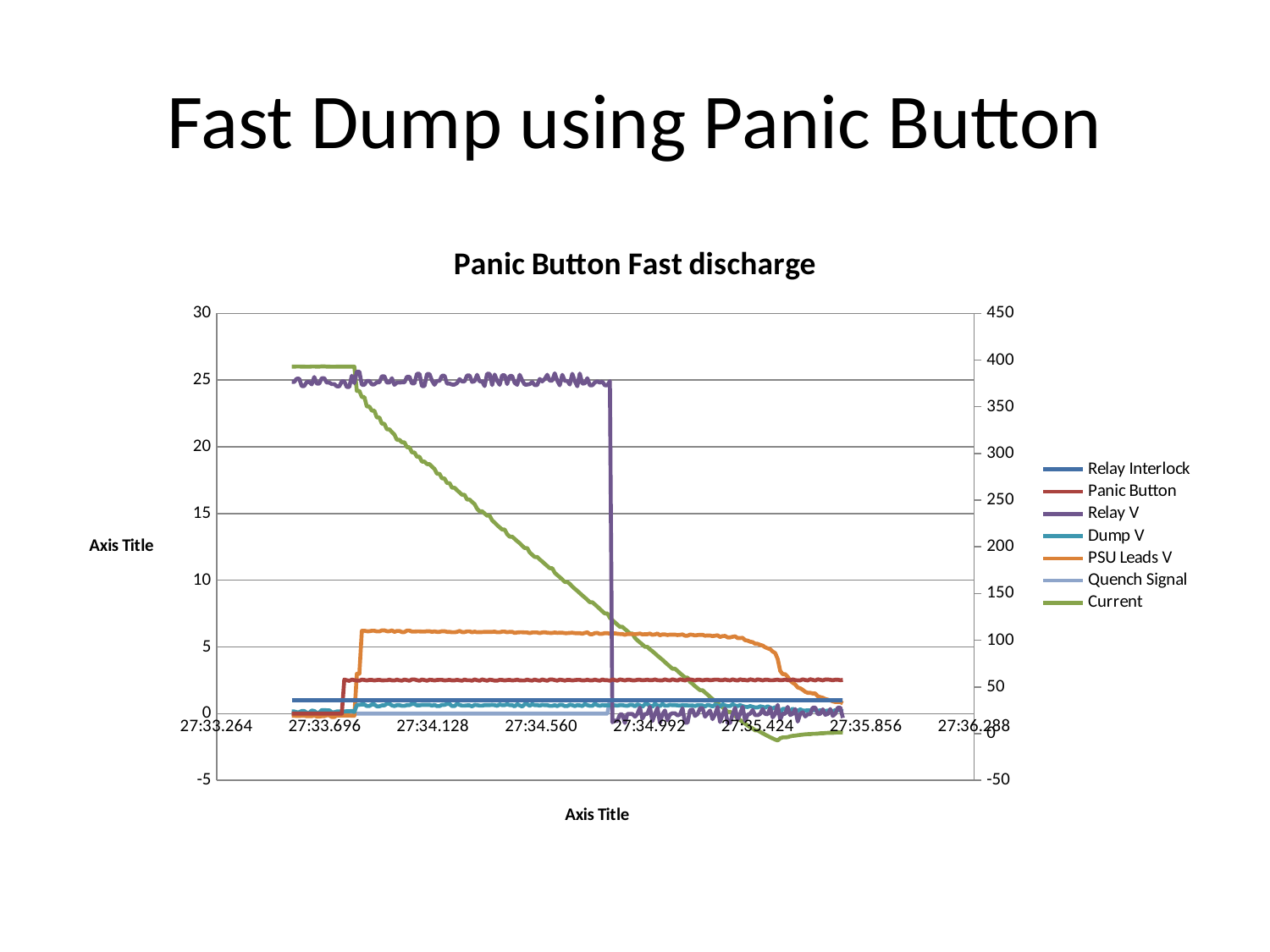
At 27:34.560, which is larger, PSU Leads V or Panic Button? PSU Leads V How many time labels are shown on the x axis? 8 How many series does the legend list? 7 At 27:34.560, which is larger, Relay V or Panic Button? Relay V After it rises near 27:33.696, is the Panic Button value greater or less than 5 on the left axis? less Does the Current series rise or fall along the x axis after 27:33.696? fall Which series is shown in green in the legend? Current What kind of chart is shown on the slide? line chart At 27:34.560, is the PSU Leads V value greater or less than 5 on the left axis? greater What is the title of the chart? Panic Button Fast discharge Before its sharp drop near 27:34.900, is the Relay V value greater or less than 20 on the left axis? greater